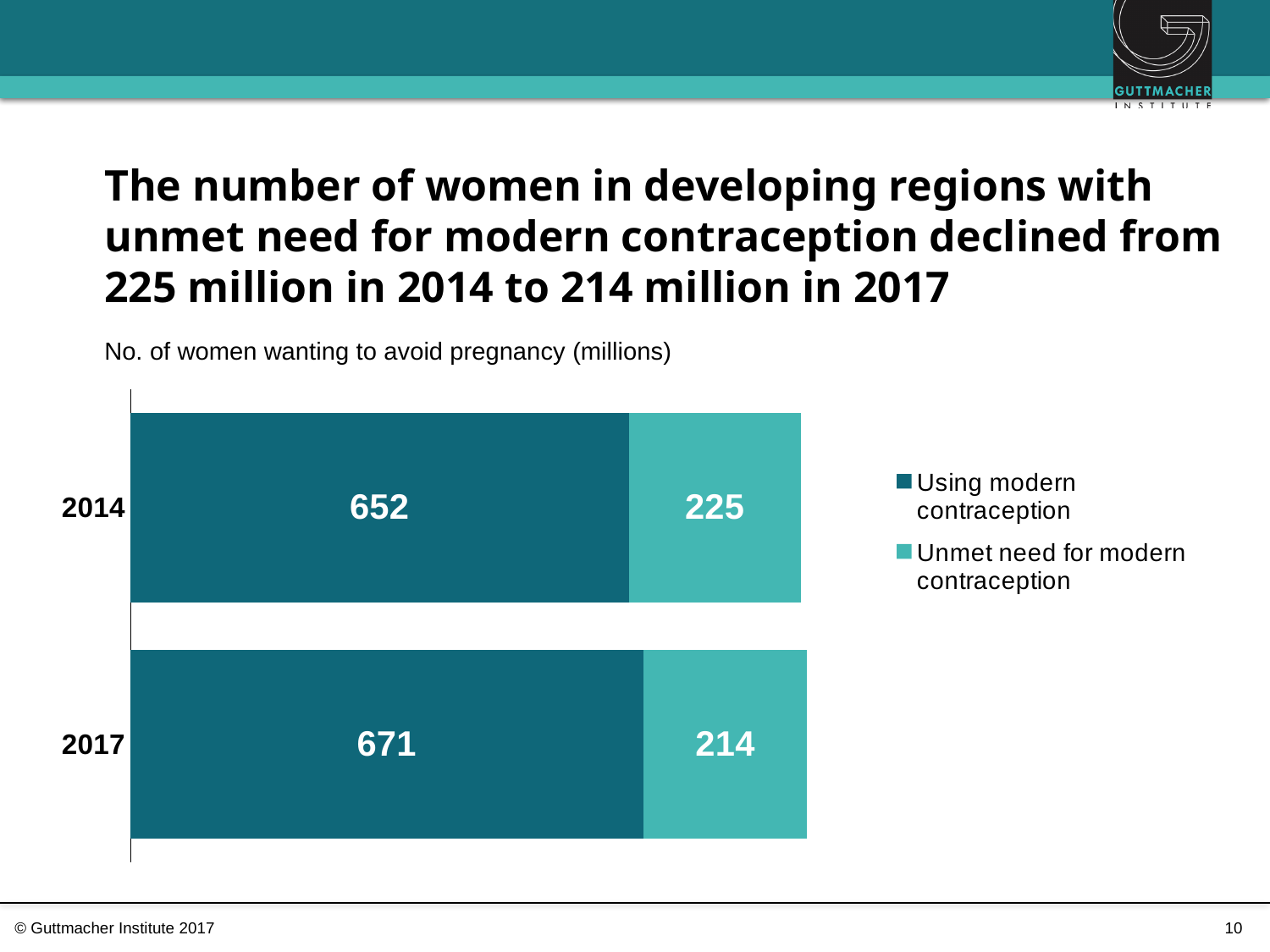
What is the value for unmet need for modern contraception in 2014? 225 How many series does the legend list? 2 What is the difference between the using modern contraception values for 2017 and 2014? 19 What is the value for using modern contraception in 2017? 671 How many women (millions) were using modern contraception in 2014? 652 What is the total number of women wanting to avoid pregnancy (millions) in 2014? 877 By how much did the unmet need for modern contraception value decline from 2014 to 2017? 11 How many years (categories) are shown in the chart? 2 What kind of chart is shown on the slide? Stacked bar chart What is the value for unmet need for modern contraception in 2017? 214 Which year has the larger value for using modern contraception, 2014 or 2017? 2017 What is the total number of women wanting to avoid pregnancy (millions) in 2017? 885